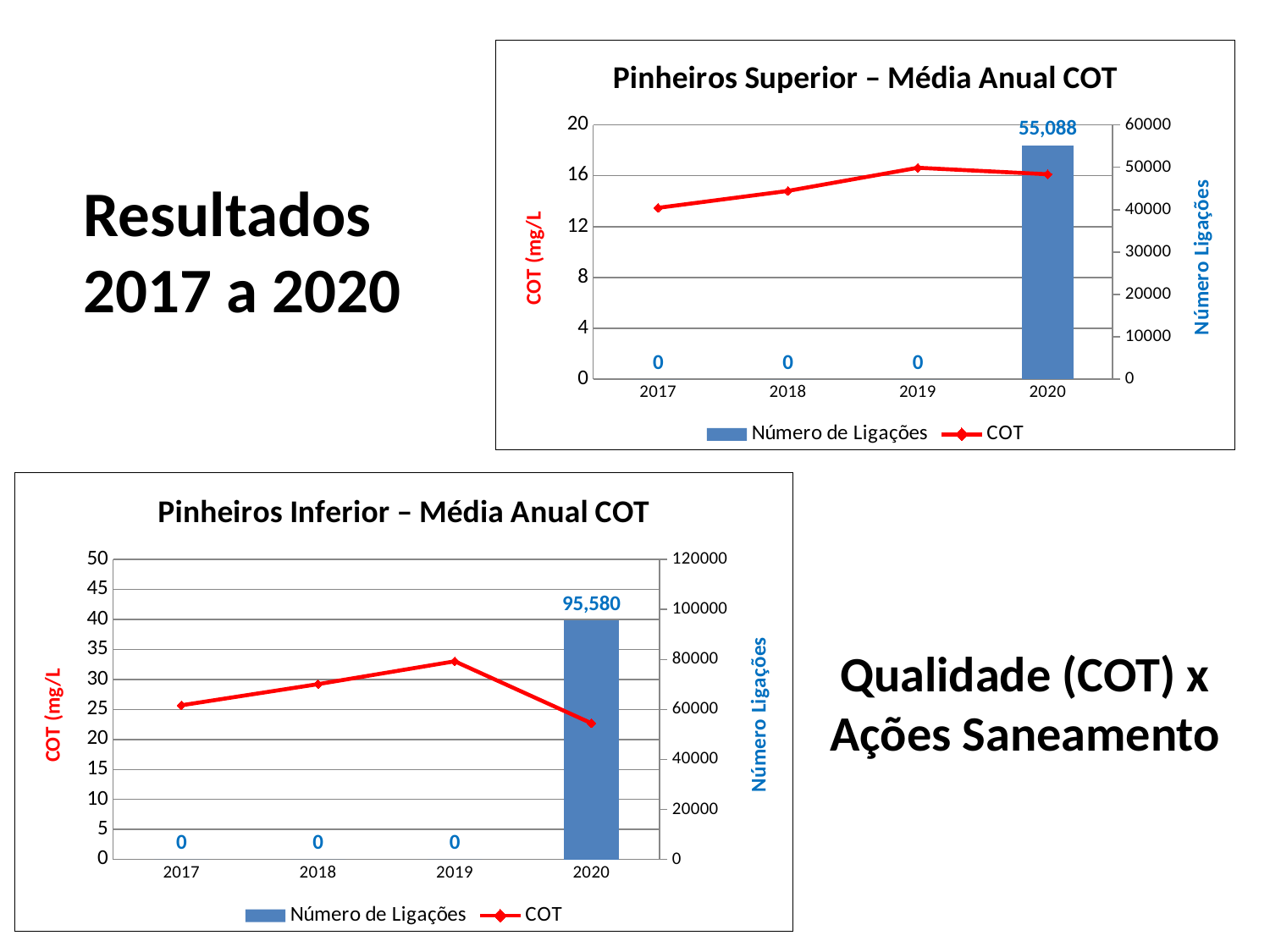
In the Pinheiros Superior – Média Anual COT chart, is the COT value for 2017 greater or less than 12? greater In the Pinheiros Inferior – Média Anual COT chart, which year has the highest Número de Ligações? 2020 In the Pinheiros Inferior – Média Anual COT chart, what is the Número de Ligações value for 2020? 95,580 In the Pinheiros Superior – Média Anual COT chart, what is the Número de Ligações value for 2020? 55,088 In the Pinheiros Superior – Média Anual COT chart, does the COT line rise or fall from 2017 to 2019? rise How many years are shown on the x axis of the Pinheiros Inferior – Média Anual COT chart? 4 In the Pinheiros Inferior – Média Anual COT chart, which year has the larger COT value, 2019 or 2020? 2019 How many series does the legend of the Pinheiros Superior – Média Anual COT chart list? 2 In the Pinheiros Inferior – Média Anual COT chart, which year has the highest COT value? 2019 In the Pinheiros Superior – Média Anual COT chart, what is the Número de Ligações value for 2017? 0 What is the title of the chart in the upper right of the slide? Pinheiros Superior – Média Anual COT In the Pinheiros Inferior – Média Anual COT chart, is the COT value for 2019 greater or less than 30? greater